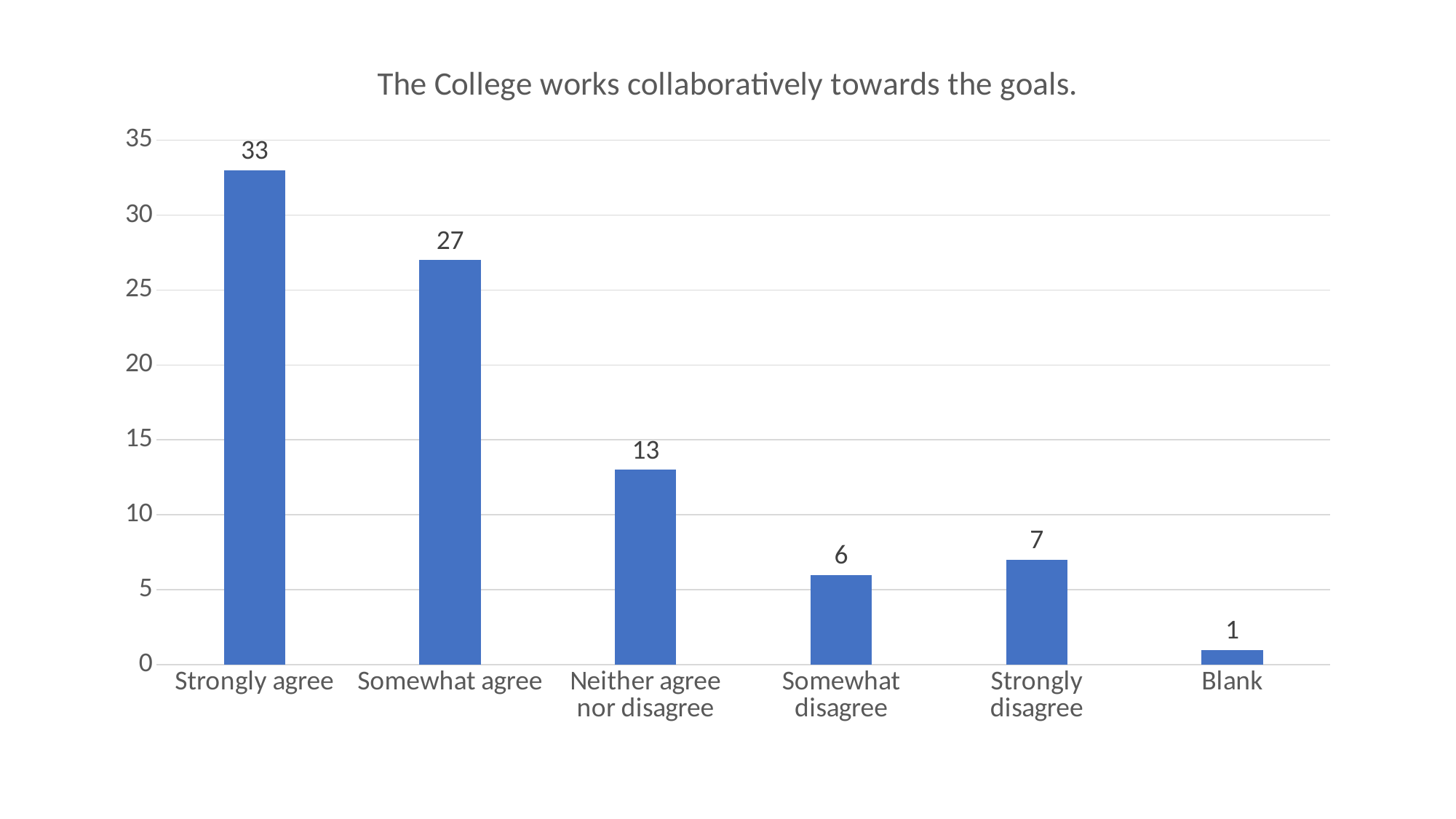
How many categories are shown on the x axis? 6 What is the difference between the values for Strongly agree and Somewhat agree? 6 What is the difference between the values for Neither agree nor disagree and Somewhat disagree? 7 What is the value for Strongly agree? 33 What kind of chart is shown on the slide? bar chart What is the value for Strongly disagree? 7 Which category has the highest value? Strongly agree Which is larger, the value for Somewhat disagree or the value for Strongly disagree? Strongly disagree What is the title of the chart? The College works collaboratively towards the goals. What is the value for Neither agree nor disagree? 13 Which category has the lowest value? Blank Is the value for Somewhat agree greater or less than 25? greater